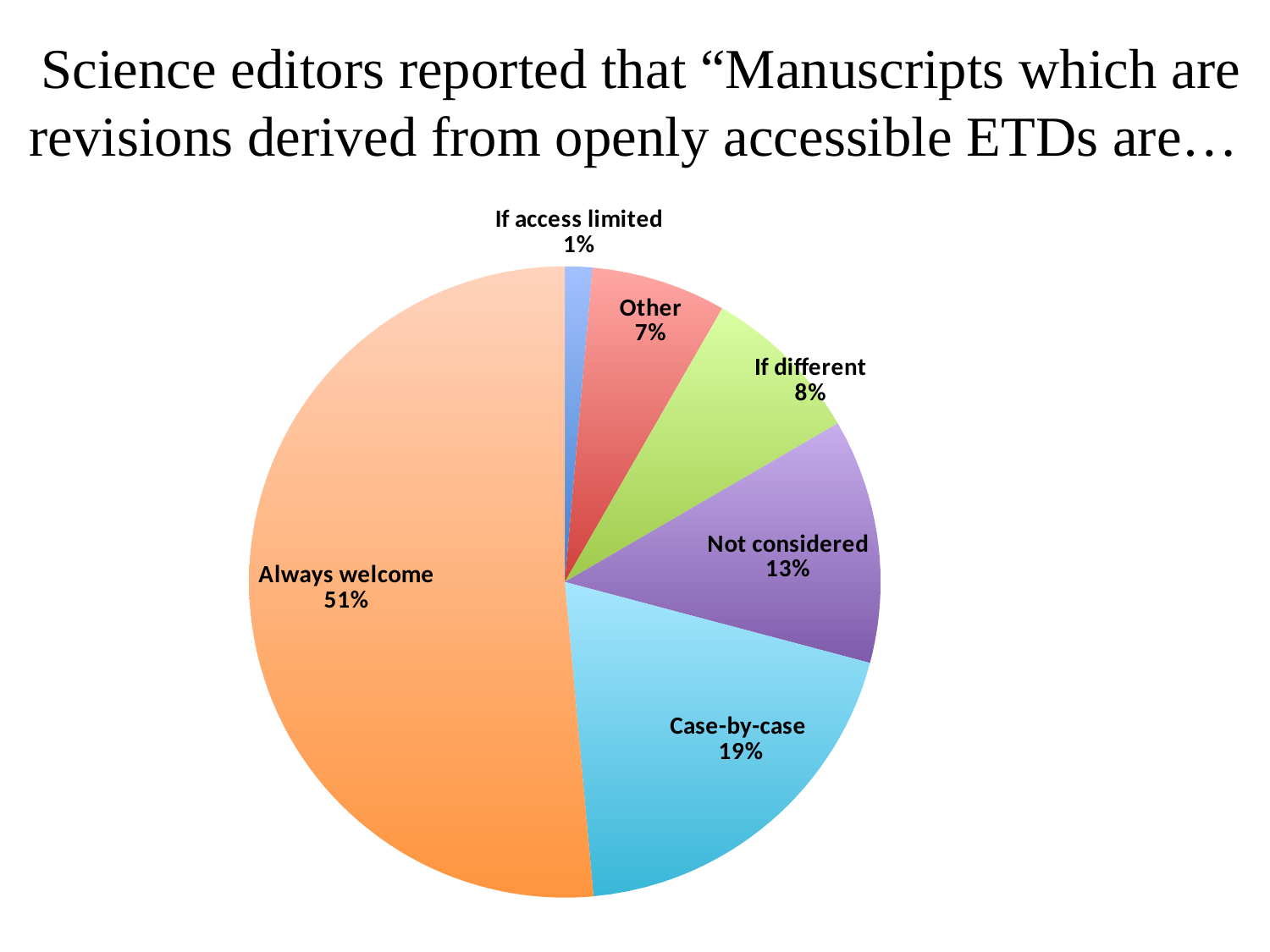
What percentage is shown for "If different"? 8% What percentage is shown for "If access limited"? 1% What kind of chart is shown on the slide? pie chart What share of the pie is labelled "Always welcome"? 51% Which category has the largest slice of the pie? Always welcome What colour is the "Case-by-case" slice? blue What percentage is shown for "Case-by-case"? 19% How many slices does the pie chart have? 6 What is the difference in percentage points between "Case-by-case" and "Not considered"? 6 Which is larger, the share for "Other" or the share for "If different"? If different What percentage is shown for "Not considered"? 13% Which category has the smallest slice of the pie? If access limited